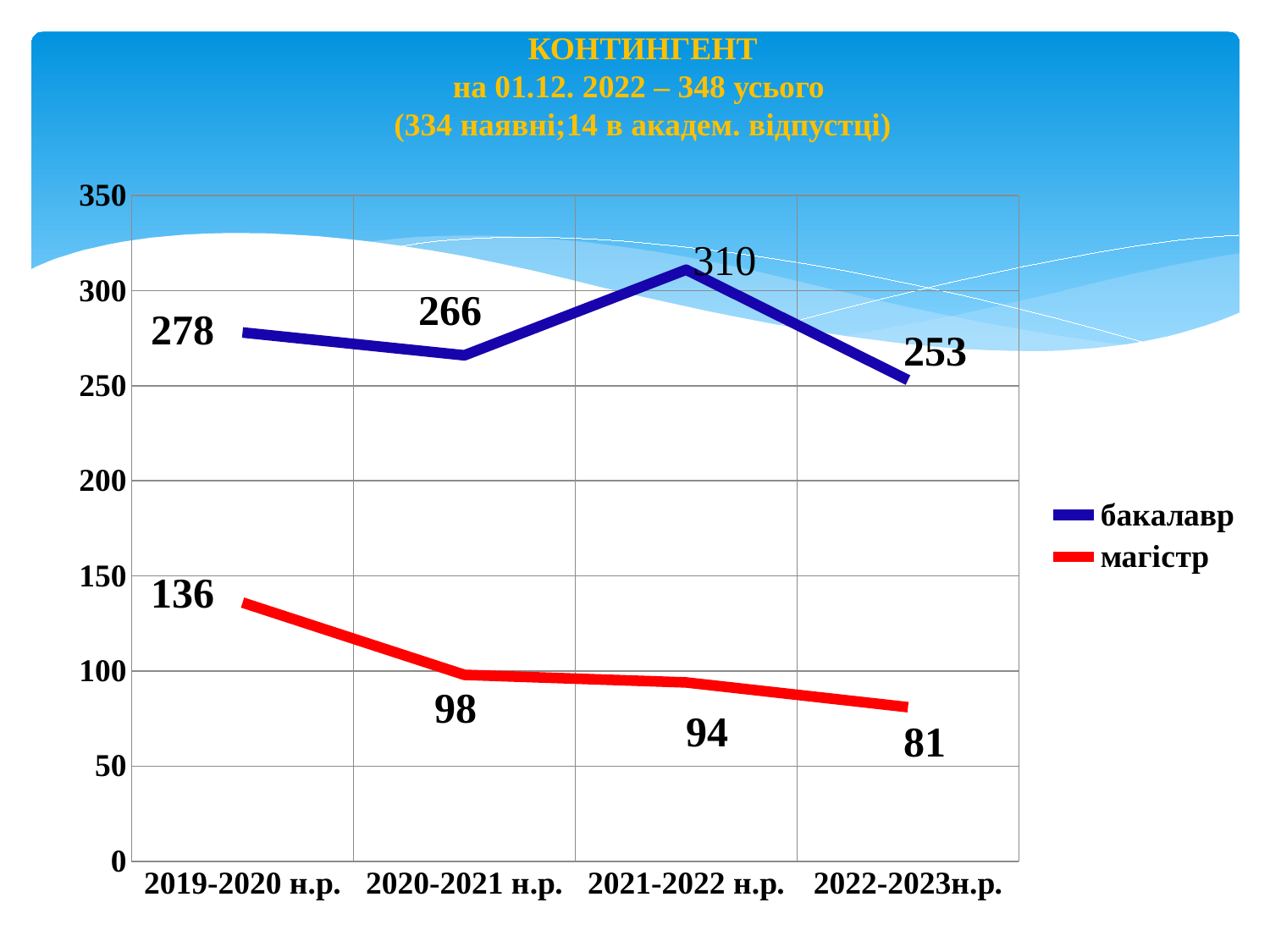
What colour is the line for магістр? red What is the difference between the бакалавр and магістр values in 2020-2021 н.р.? 168 Does the магістр series rise or fall from 2019-2020 н.р. to 2022-2023н.р.? fall What is the value for бакалавр in 2021-2022 н.р.? 310 In which academic year is the магістр value lowest? 2022-2023н.р. What is the value for бакалавр in 2022-2023н.р.? 253 How many academic years are shown on the x axis? 4 Which is larger: the магістр value in 2020-2021 н.р. or in 2021-2022 н.р.? 2020-2021 н.р. What is the value for магістр in 2019-2020 н.р.? 136 In which academic year is the бакалавр value highest? 2021-2022 н.р. How many series does the legend list? 2 What kind of chart is shown on the slide? line chart